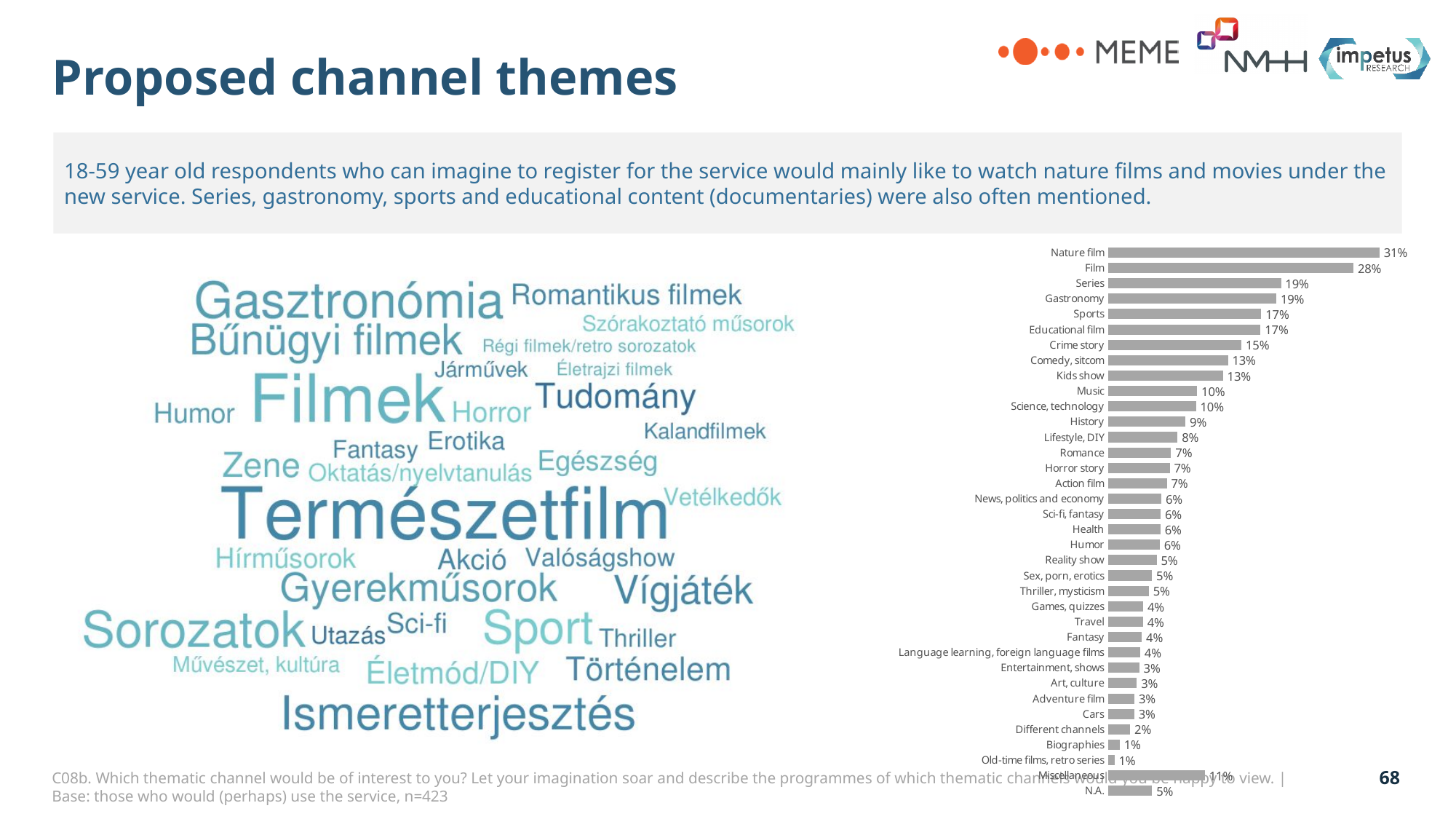
In the bar chart, what is the value for Lifestyle, DIY? 8% What kind of chart is shown on the right side of the slide? Bar chart In the bar chart, which is larger, the value for History or the value for Travel? History In the bar chart, which category has the highest value? Nature film In the bar chart, what is the difference between the values for Nature film and Film? 3% In the bar chart, what percentage is shown for Crime story? 15% In the bar chart, what percentage is shown for Nature film? 31% In the bar chart, what is the value for Kids show? 13% In the bar chart, what percentage is shown for Miscellaneous? 11% In the bar chart, what is the value for Gastronomy? 19% In the bar chart, which is larger, the value for Sports or the value for Comedy, sitcom? Sports In the bar chart, what is the difference between the values for Series and Music? 9%